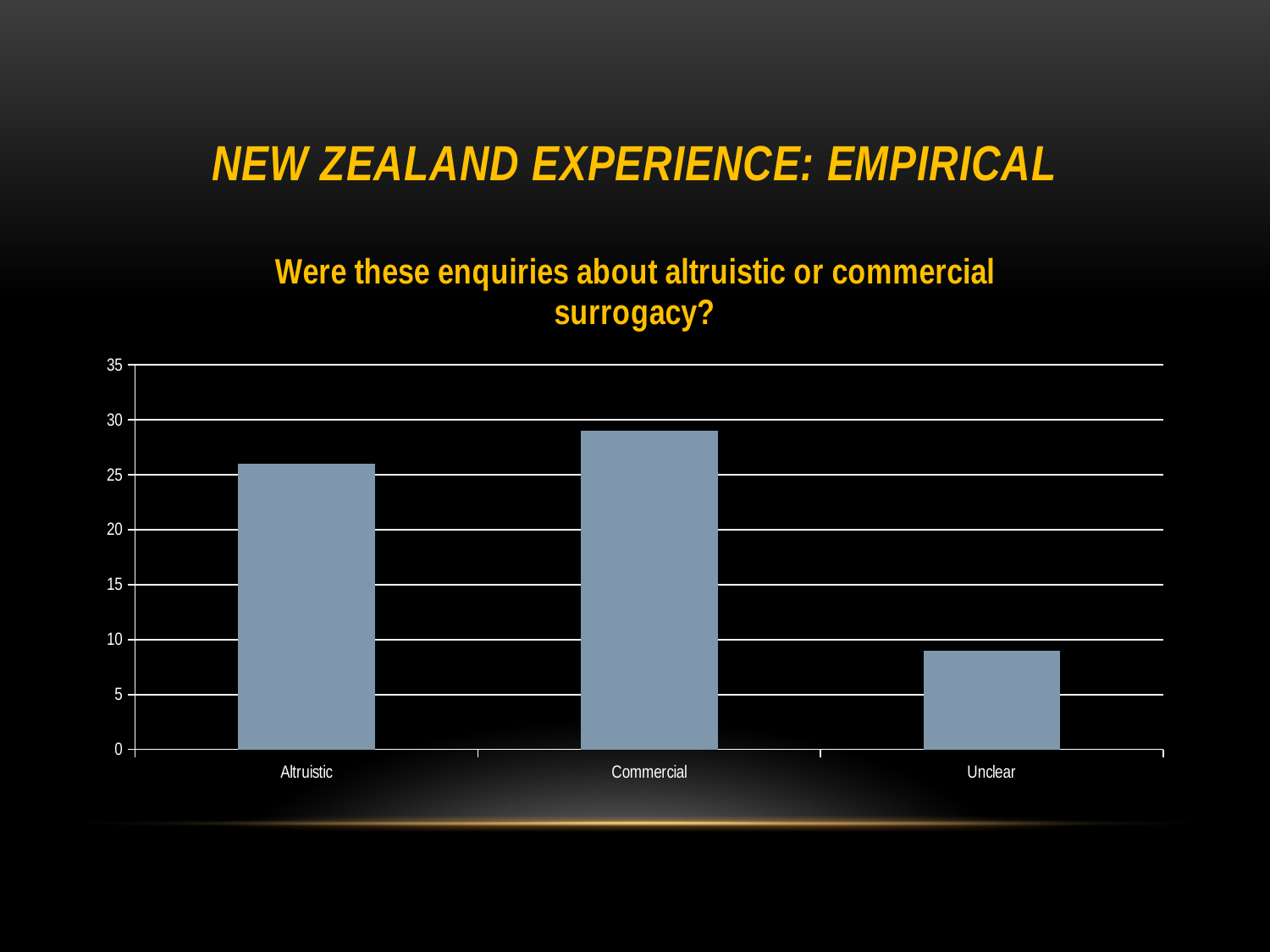
Is the value for Unclear greater or less than 5? greater Which is larger, the value for Altruistic or the value for Unclear? Altruistic How many categories are shown on the x axis of the chart? 3 Is the value for Unclear greater or less than 10? less Is the value for Commercial greater or less than 30? less Which category has the lowest bar in the chart? Unclear Which category has the highest bar in the chart? Commercial What is the title of the chart on the slide? Were these enquiries about altruistic or commercial surrogacy? Which is larger, the value for Altruistic or the value for Commercial? Commercial What kind of chart is shown on the slide? bar chart